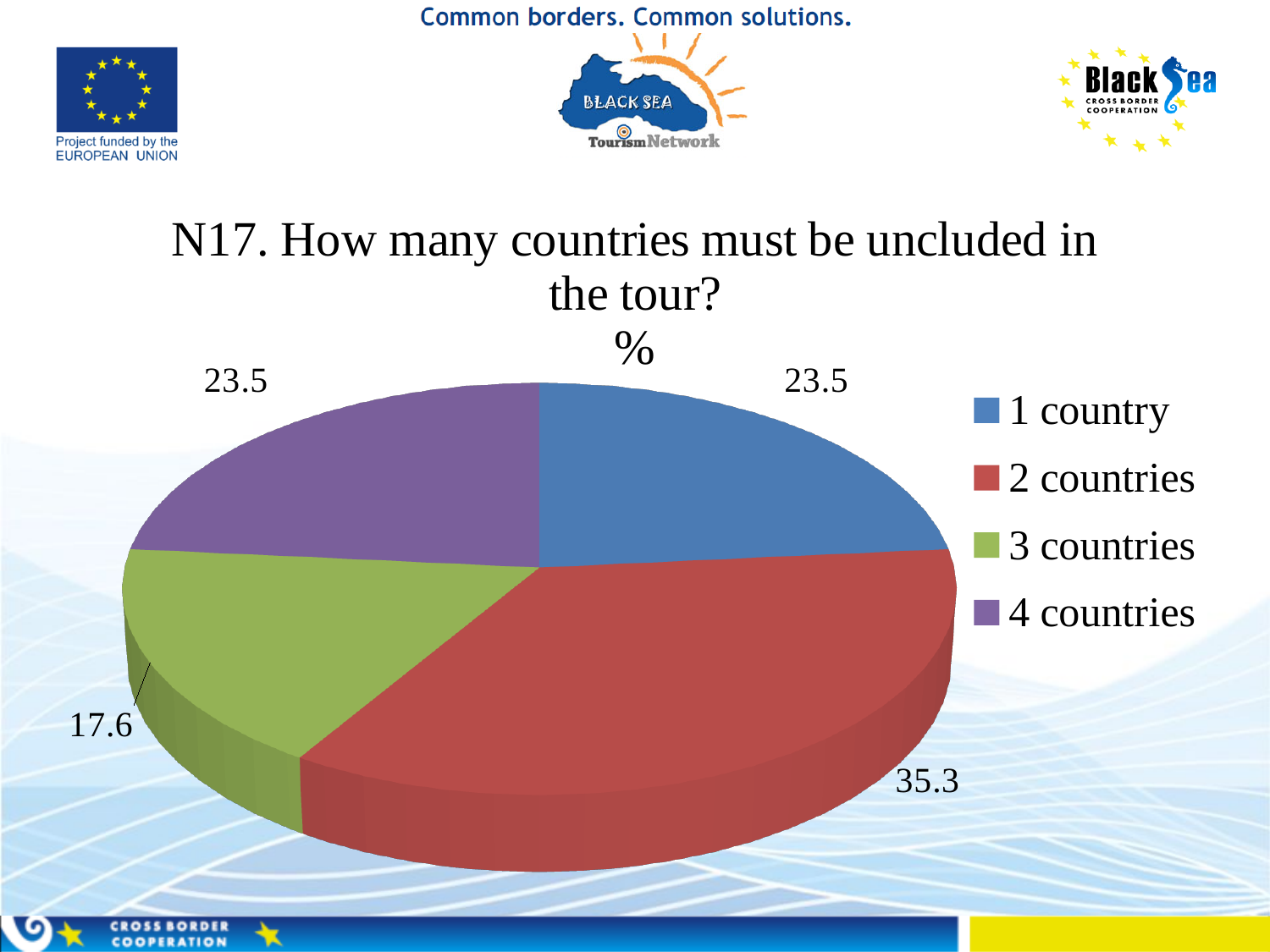
What is the value for 2 countries? 35.3 Which colour represents 4 countries in the legend? Purple What is the difference between the values for 2 countries and 3 countries? 17.7 What is the value for 1 country? 23.5 Which is larger, the value for 2 countries or the value for 1 country? 2 countries What is the value for 4 countries? 23.5 Which category has the largest slice of the pie? 2 countries Which category has the smallest slice of the pie? 3 countries What is the title shown above the pie chart? % What kind of chart is shown on the slide? Pie chart How many categories does the pie chart have? 4 What is the value for 3 countries? 17.6